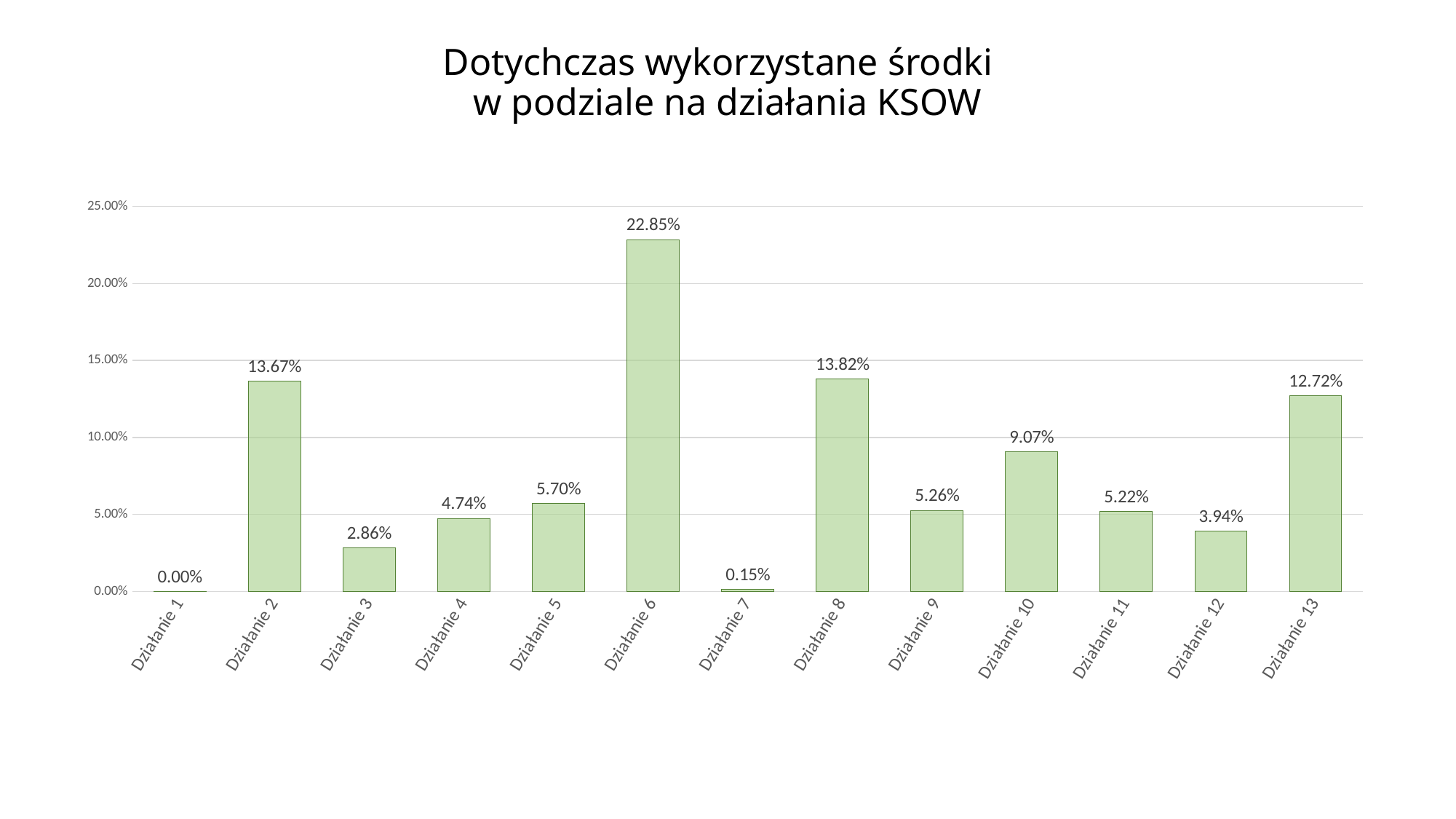
What is the difference between the values for Działanie 8 and Działanie 2? 0.15% Which category has the highest value? Działanie 6 What kind of chart is shown on the slide? bar chart What is the value for Działanie 6? 22.85% What is the title of the chart? Dotychczas wykorzystane środki w podziale na działania KSOW Which is larger, the value for Działanie 4 or the value for Działanie 12? Działanie 4 How many categories are shown on the x axis? 13 Is the value for Działanie 10 greater or less than 10.00%? less What is the difference between the values for Działanie 6 and Działanie 13? 10.13% What is the value for Działanie 13? 12.72% What is the value for Działanie 10? 9.07% Which category has the lowest value? Działanie 1